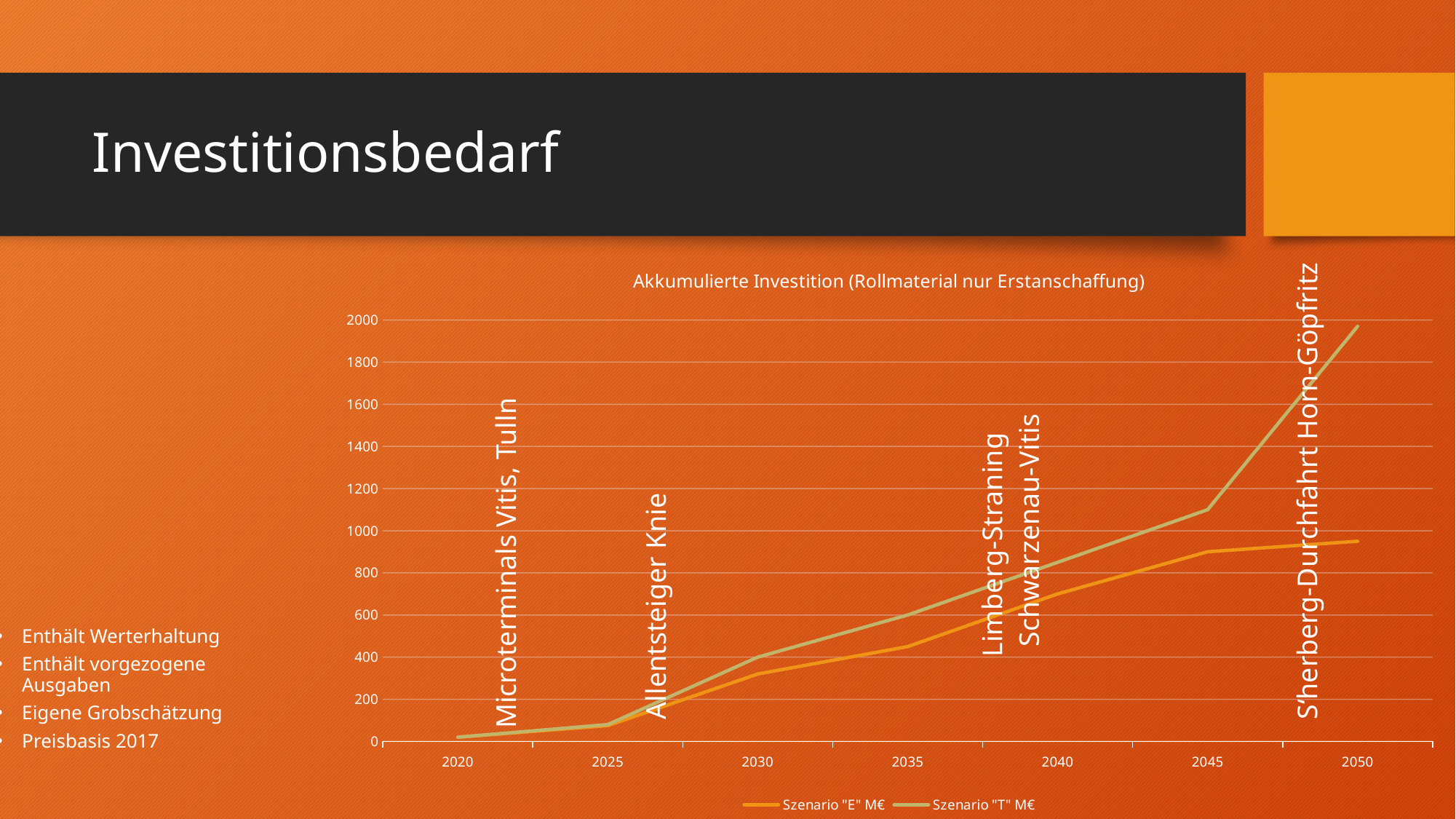
What kind of chart is shown on the slide? line chart How many years are marked along the x axis? 7 Is the value for Szenario "E" M€ in 2050 greater or less than 1000? less In 2050, which series has the higher value, Szenario "E" M€ or Szenario "T" M€? Szenario "T" M€ In which year does Szenario "T" M€ reach its highest value? 2050 Is the value for Szenario "T" M€ in 2045 greater or less than 1000? greater How many series does the legend list? 2 Is the value for Szenario "E" M€ in 2035 greater or less than 600? less Do the values for Szenario "T" M€ rise or fall from 2020 to 2050? rise What is the title of the chart? Akkumulierte Investition (Rollmaterial nur Erstanschaffung) What are the two series names shown in the legend? Szenario "E" M€ and Szenario "T" M€